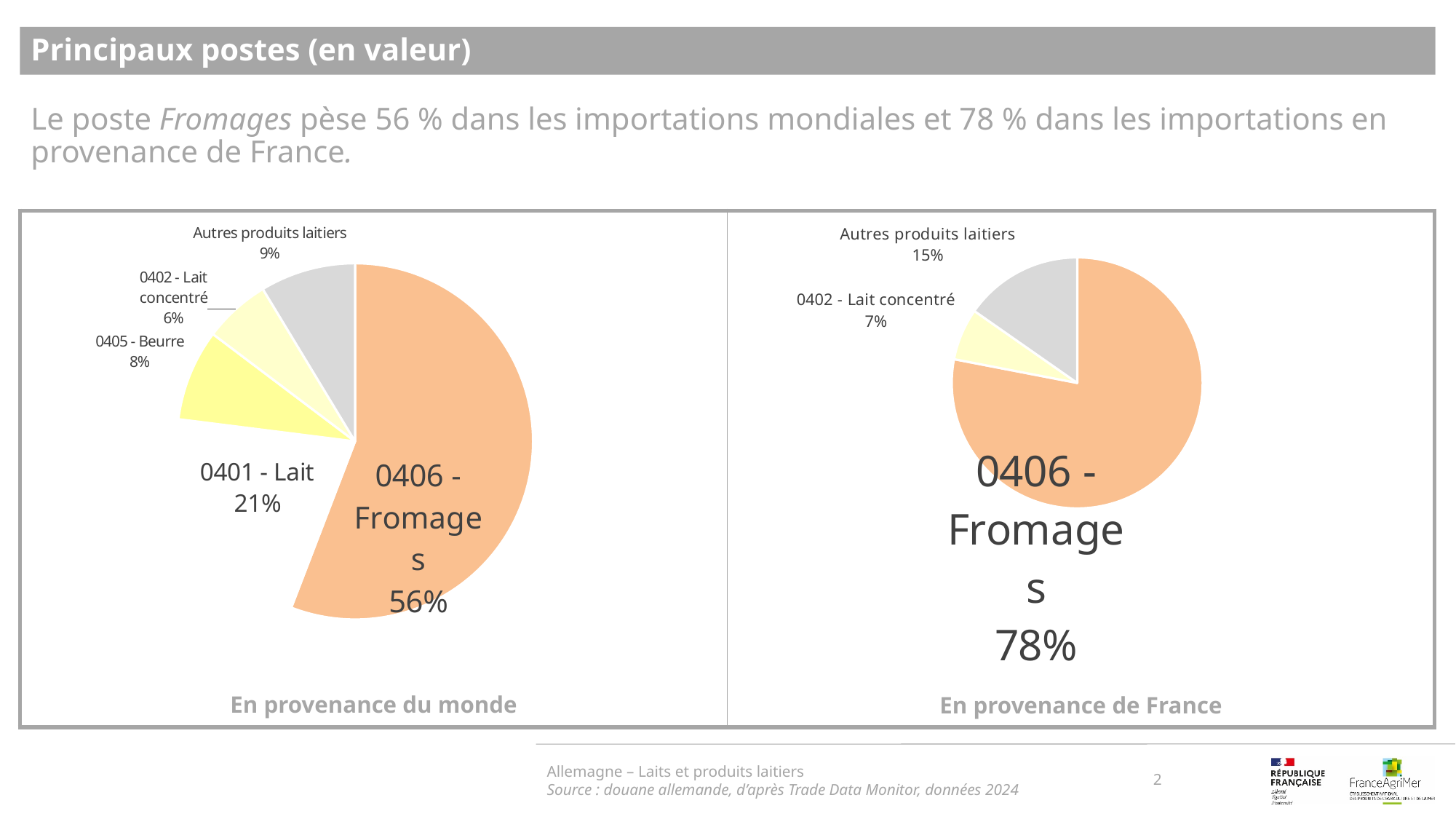
In the 'En provenance de France' chart, what share does 0406 - Fromages have? 78% In the 'En provenance de France' chart, which category has the largest share? 0406 - Fromages In the 'En provenance du monde' chart, what share does 0406 - Fromages have? 56% In the 'En provenance du monde' chart, what is the difference between the shares of 0406 - Fromages and 0401 - Lait? 35 percentage points How many slices does the 'En provenance du monde' chart have? 5 In the 'En provenance du monde' chart, what share does 0401 - Lait have? 21% In the 'En provenance du monde' chart, which category has the smallest share? 0402 - Lait concentré In the 'En provenance de France' chart, which is larger: Autres produits laitiers or 0402 - Lait concentré? Autres produits laitiers What type of chart is used on this slide? Pie chart In the 'En provenance de France' chart, what share does Autres produits laitiers have? 15% In the 'En provenance du monde' chart, what share does 0405 - Beurre have? 8% How many slices does the 'En provenance de France' chart have? 3